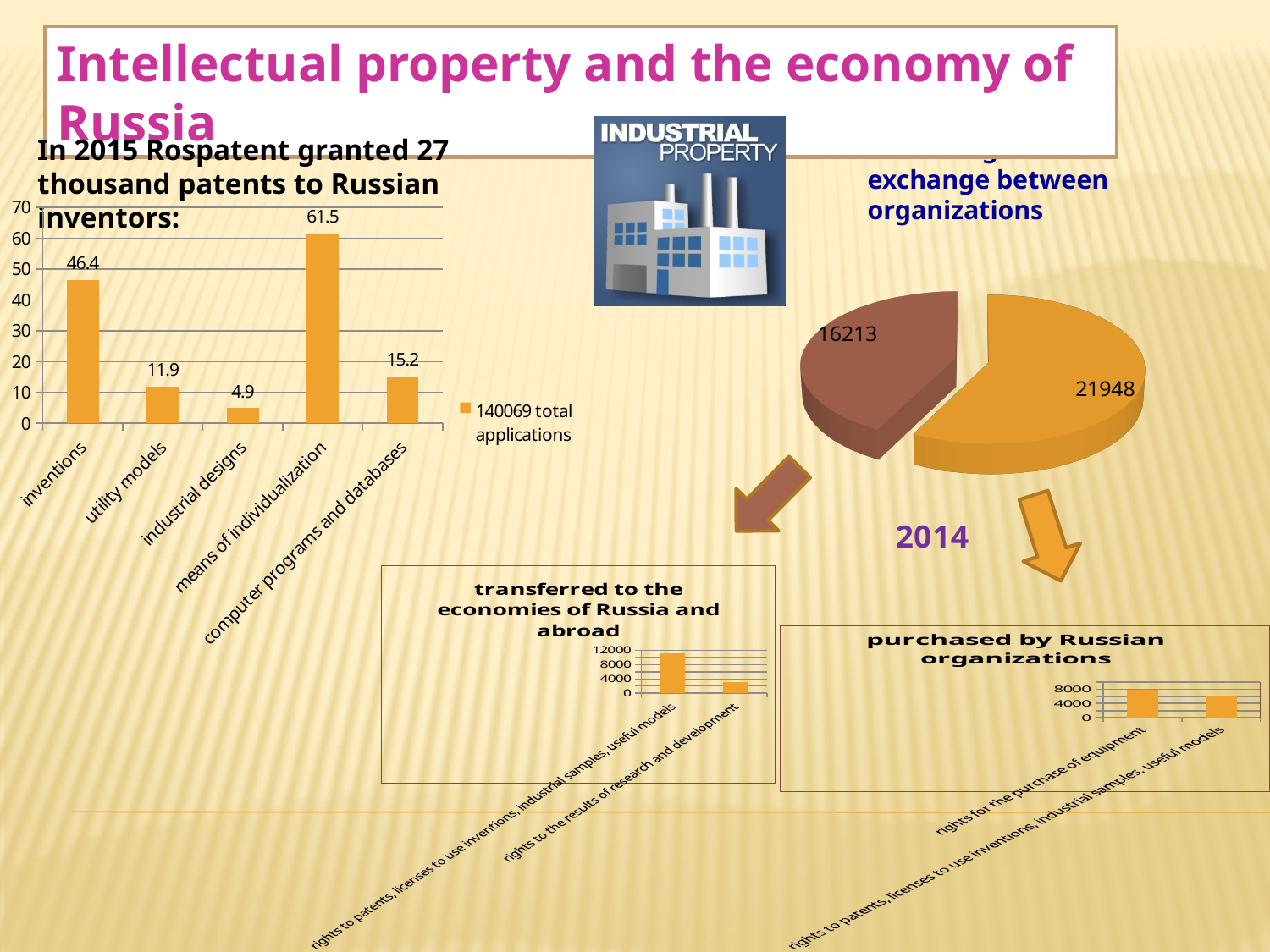
In the bar chart on the left of the slide, what is the value for means of individualization? 61.5 In the bar chart on the left of the slide, which is larger: the value for utility models or the value for computer programs and databases? computer programs and databases How many categories are shown in the bar chart on the left of the slide? 5 In the chart titled 'transferred to the economies of Russia and abroad', is the value for rights to patents, licenses to use inventions, industrial samples, useful models greater or less than 8000? greater In the bar chart on the left of the slide, what is the value for inventions? 46.4 In the chart titled 'purchased by Russian organizations', is the value for rights for the purchase of equipment greater or less than 4000? greater In the bar chart on the left of the slide, what is the value for industrial designs? 4.9 In the pie chart on the right of the slide, which slice is larger: the one labelled 16213 or the one labelled 21948? 21948 In the bar chart on the left of the slide, which category has the highest value? means of individualization In the bar chart on the left of the slide, which category has the lowest value? industrial designs What does the legend of the bar chart on the left of the slide say? 140069 total applications In the bar chart on the left of the slide, what is the difference between the values for means of individualization and inventions? 15.1